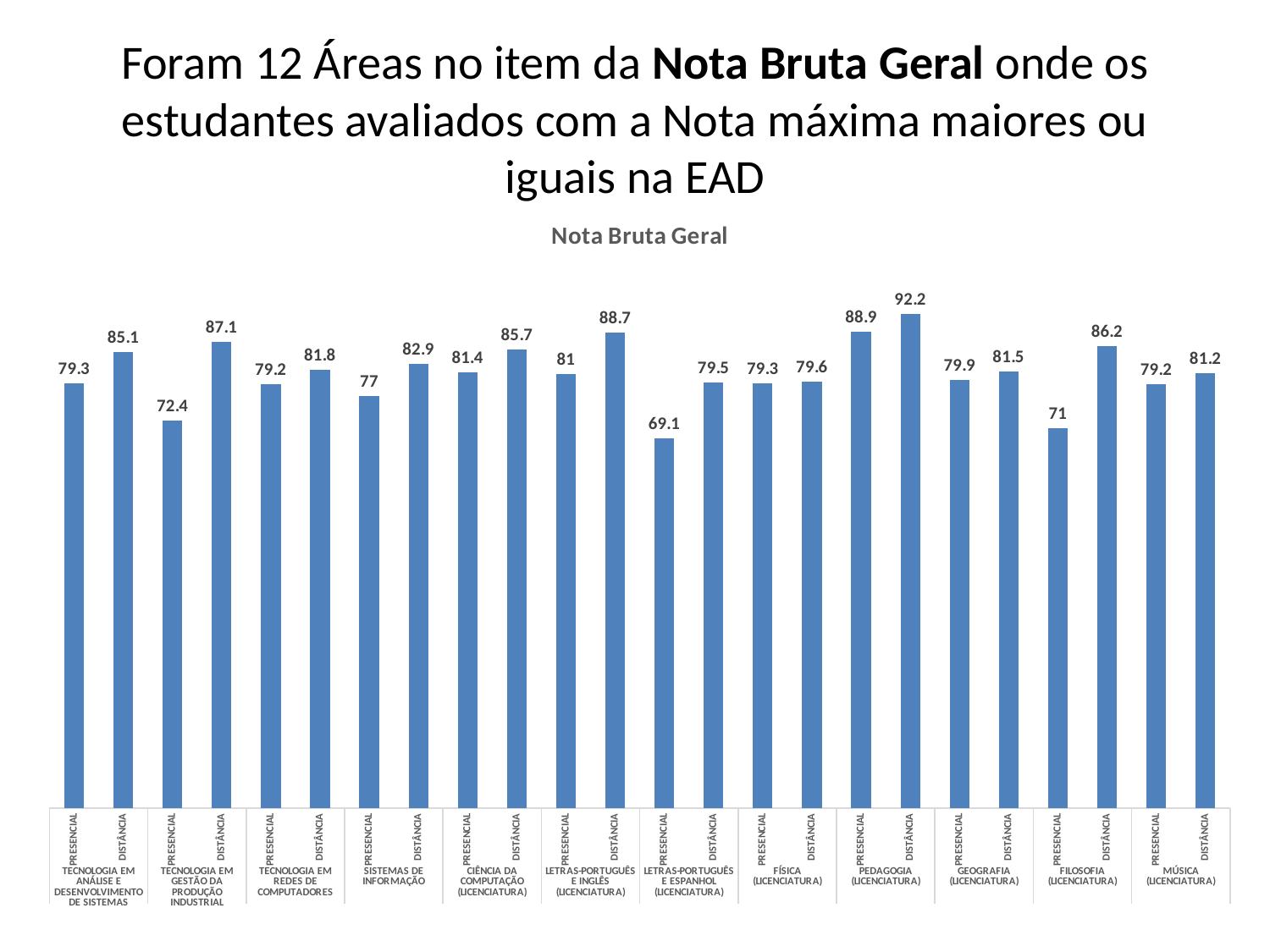
What is the Nota Bruta Geral value for Letras-Português e Espanhol (Licenciatura) Presencial? 69.1 What is the difference between the Distância and Presencial values for Tecnologia em Gestão da Produção Industrial? 14.7 What is the Nota Bruta Geral value for Pedagogia (Licenciatura) Distância? 92.2 What type of chart is shown on the slide? Bar chart What is the difference between the Distância and Presencial values for Filosofia (Licenciatura)? 15.2 How many bars are plotted in the chart? 24 What is the title of the chart? Nota Bruta Geral What is the value for Sistemas de Informação Presencial? 77 Which bar has the lowest value in the chart? Letras-Português e Espanhol (Licenciatura) Presencial What is the value for Filosofia (Licenciatura) Distância? 86.2 Which is larger for Ciência da Computação (Licenciatura): the Presencial value or the Distância value? Distância Which bar has the highest value in the chart? Pedagogia (Licenciatura) Distância